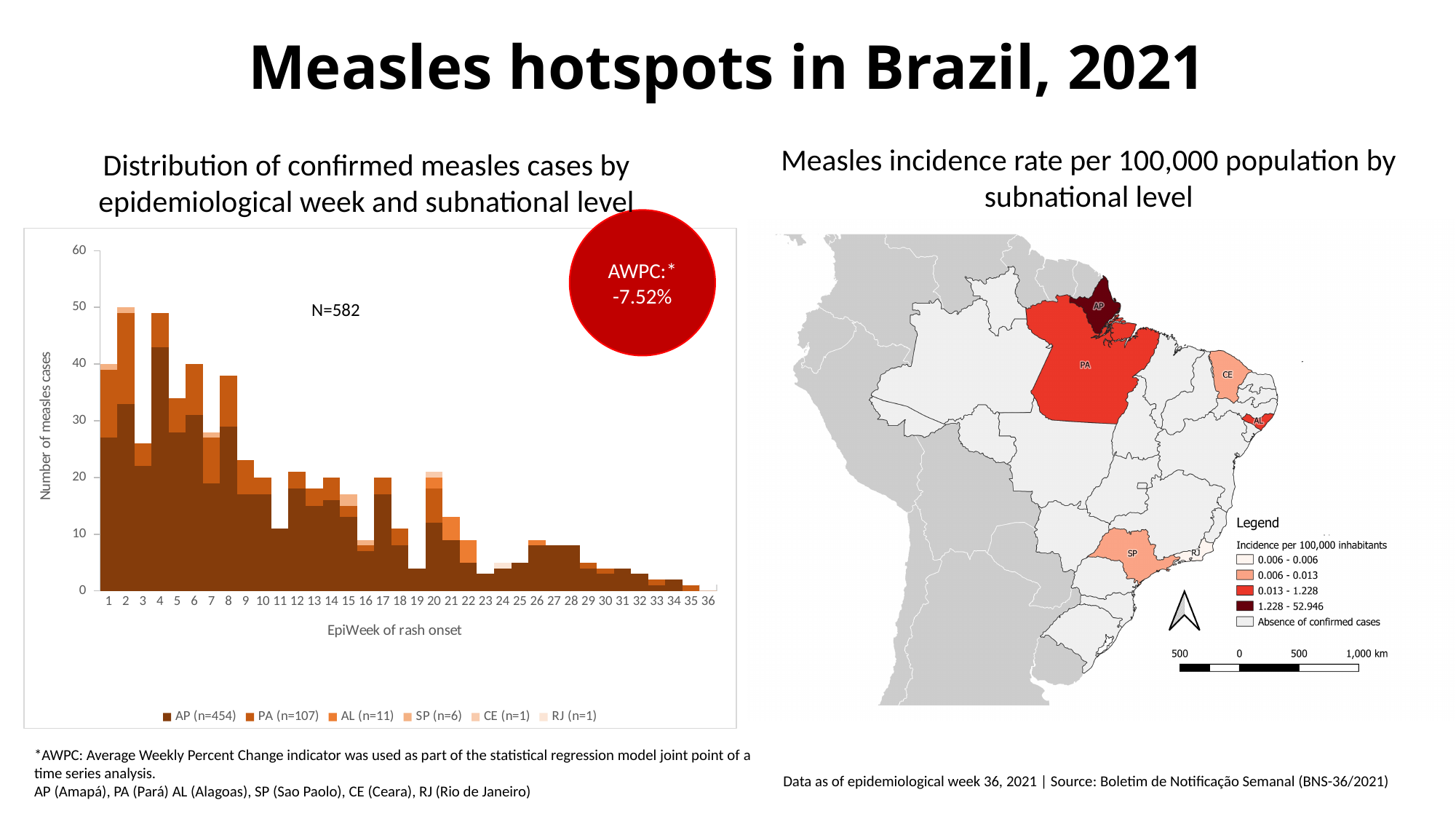
In the bar chart, is the total number of cases in EpiWeek 2 greater or less than 40? greater According to the bar chart legend, how many confirmed cases (n) are attributed to PA? 107 In the bar chart, how many series does the legend list? 6 What kind of chart is the 'Distribution of confirmed measles cases by epidemiological week and subnational level' chart? bar chart In the bar chart, do the weekly case counts generally rise or fall from EpiWeek 1 to EpiWeek 36? fall According to the bar chart legend, how many more cases does AP have than PA? 347 In the bar chart, which EpiWeek has more total cases, week 6 or week 16? week 6 In the bar chart, is the total number of cases in EpiWeek 23 greater or less than 10? less In the bar chart, is the total number of cases in EpiWeek 1 greater or less than 30? greater What is the AWPC value shown in the red circle on the bar chart? -7.52% What is the total N shown on the bar chart? N=582 In the bar chart, how many epidemiological weeks are shown on the x axis? 36